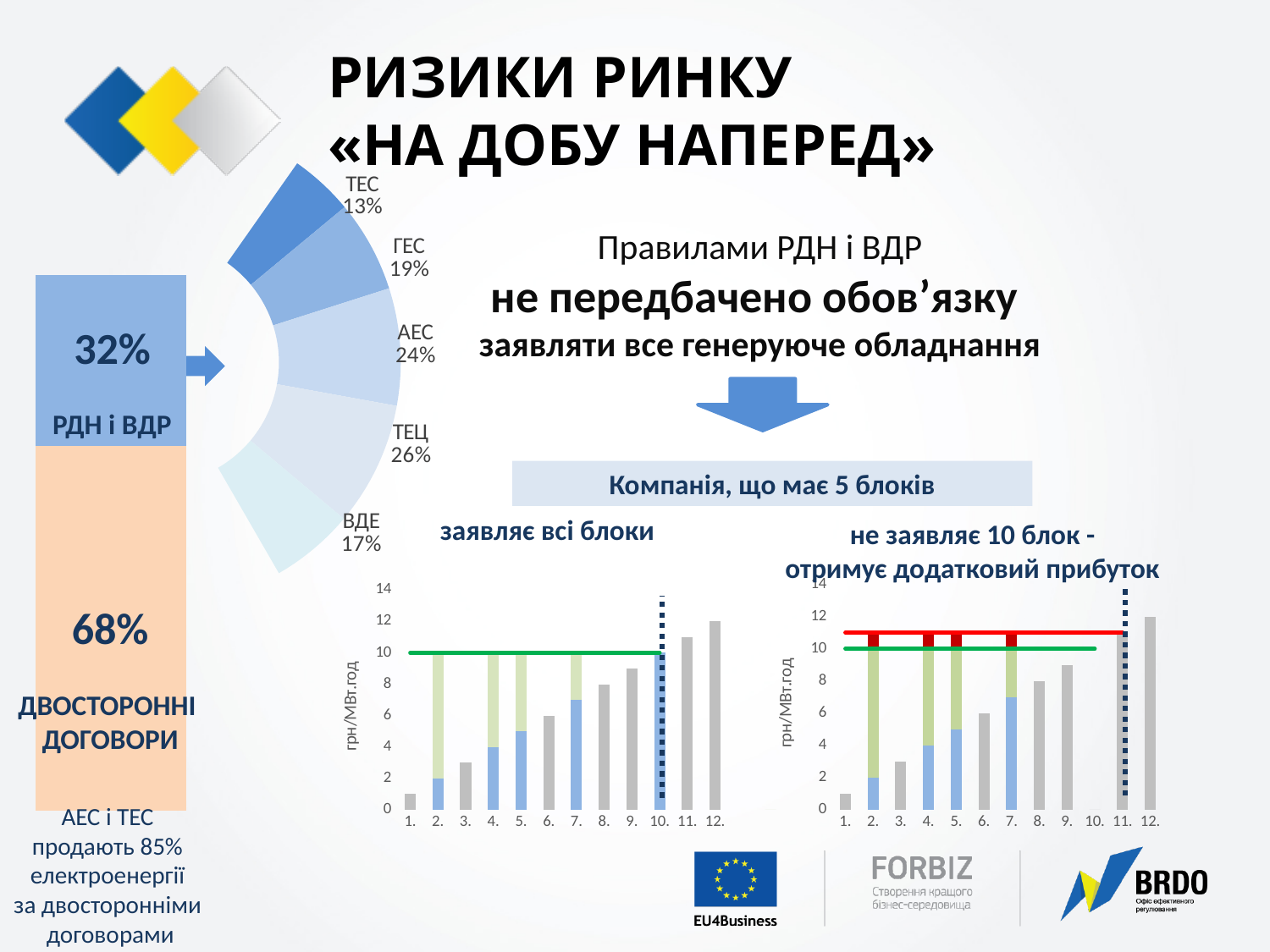
In the stacked bar on the left, what is the share for ДВОСТОРОННІ ДОГОВОРИ? 68% In the chart titled 'не заявляє 10 блок - отримує додатковий прибуток', is the value for category 3 greater or less than 4? less In the fan-shaped chart of generation shares, which category has the smallest share? ТЕС In the fan-shaped chart of generation shares, what is the share for ТЕЦ? 26% In the stacked bar on the left, what is the share for РДН і ВДР? 32% In the fan-shaped chart of generation shares, which category has the largest share? ТЕЦ In the chart titled 'заявляє всі блоки', is the value for category 12 greater or less than 10? greater In the chart titled 'заявляє всі блоки', how many categories are on the x axis? 12 In the fan-shaped chart of generation shares, what is the difference between the shares of АЕС and ГЕС? 5% What is the y-axis label of the chart titled 'заявляє всі блоки'? грн/МВт.год In the fan-shaped chart of generation shares, how many categories are shown? 5 In the fan-shaped chart of generation shares, what is the share for ТЕС? 13%